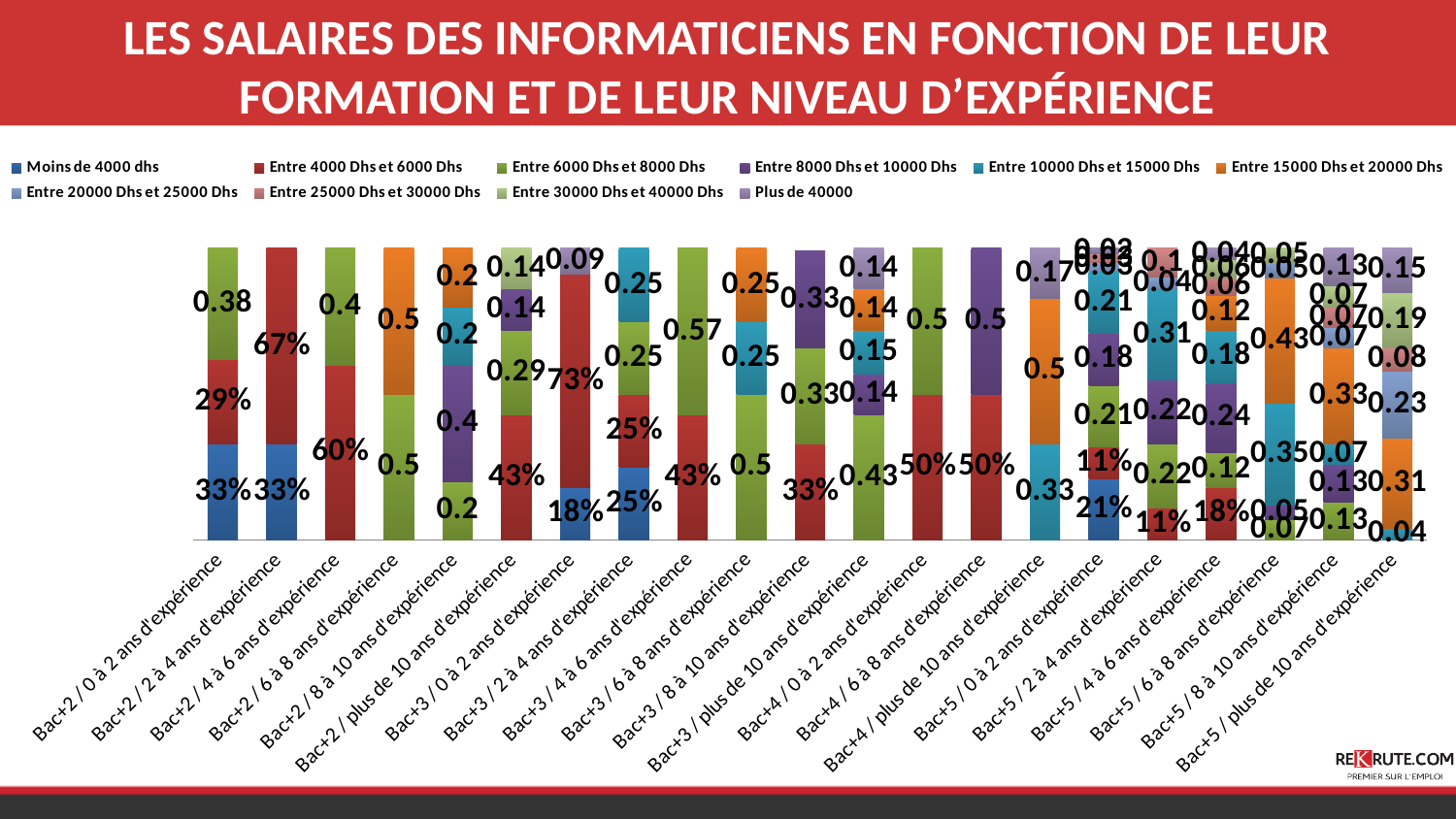
Which is larger for 'Bac+3 / 0 à 2 ans d'expérience': the 'Moins de 4000 dhs' segment or the 'Entre 4000 Dhs et 6000 Dhs' segment? Entre 4000 Dhs et 6000 Dhs What is the value of the 'Entre 15000 Dhs et 20000 Dhs' segment for 'Bac+4 / plus de 10 ans d'expérience'? 0.5 What is the value of the 'Entre 4000 Dhs et 6000 Dhs' segment for 'Bac+3 / 0 à 2 ans d'expérience'? 73% What is the value of the 'Entre 6000 Dhs et 8000 Dhs' segment for 'Bac+3 / 4 à 6 ans d'expérience'? 0.57 What is the difference between the 'Entre 4000 Dhs et 6000 Dhs' segment and the 'Moins de 4000 dhs' segment for 'Bac+2 / 2 à 4 ans d'expérience'? 34% What is the value of the 'Entre 4000 Dhs et 6000 Dhs' segment for 'Bac+2 / 2 à 4 ans d'expérience'? 67% What is the title of the chart on the slide? Les salaires des informaticiens en fonction de leur formation et de leur niveau d'expérience What is the value of the 'Moins de 4000 dhs' segment for 'Bac+2 / 0 à 2 ans d'expérience'? 33% What kind of chart is shown on the slide? Stacked bar chart How many categories (formation / experience combinations) are shown along the x axis? 21 What is the value of the 'Entre 4000 Dhs et 6000 Dhs' segment for 'Bac+5 / 0 à 2 ans d'expérience'? 11% How many series does the legend list? 10